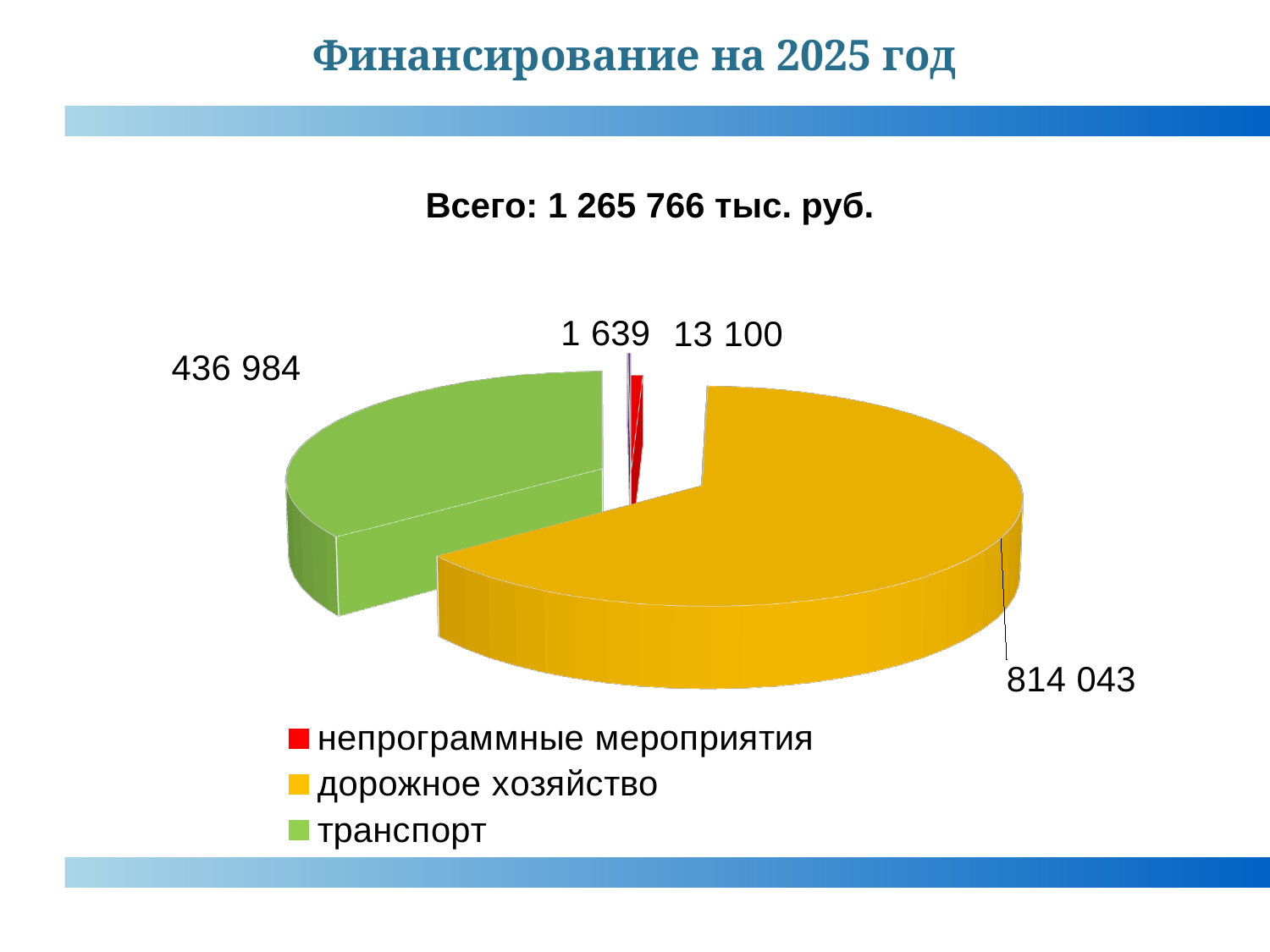
Which category has the largest slice of the pie chart? дорожное хозяйство How many data labels are printed on the pie chart? 4 What is the difference between the values for дорожное хозяйство and транспорт? 377 059 What is the difference between the values for транспорт and непрограммные мероприятия? 423 884 What kind of chart is shown on the slide? pie chart Which is larger, the value for транспорт or the value for непрограммные мероприятия? транспорт What colour is the slice for дорожное хозяйство? yellow What total amount is stated above the pie chart? 1 265 766 тыс. руб. What is the value for дорожное хозяйство in the pie chart? 814 043 What is the value for транспорт in the pie chart? 436 984 What is the value for непрограммные мероприятия in the pie chart? 13 100 What is the smallest value printed as a data label on the pie chart? 1 639